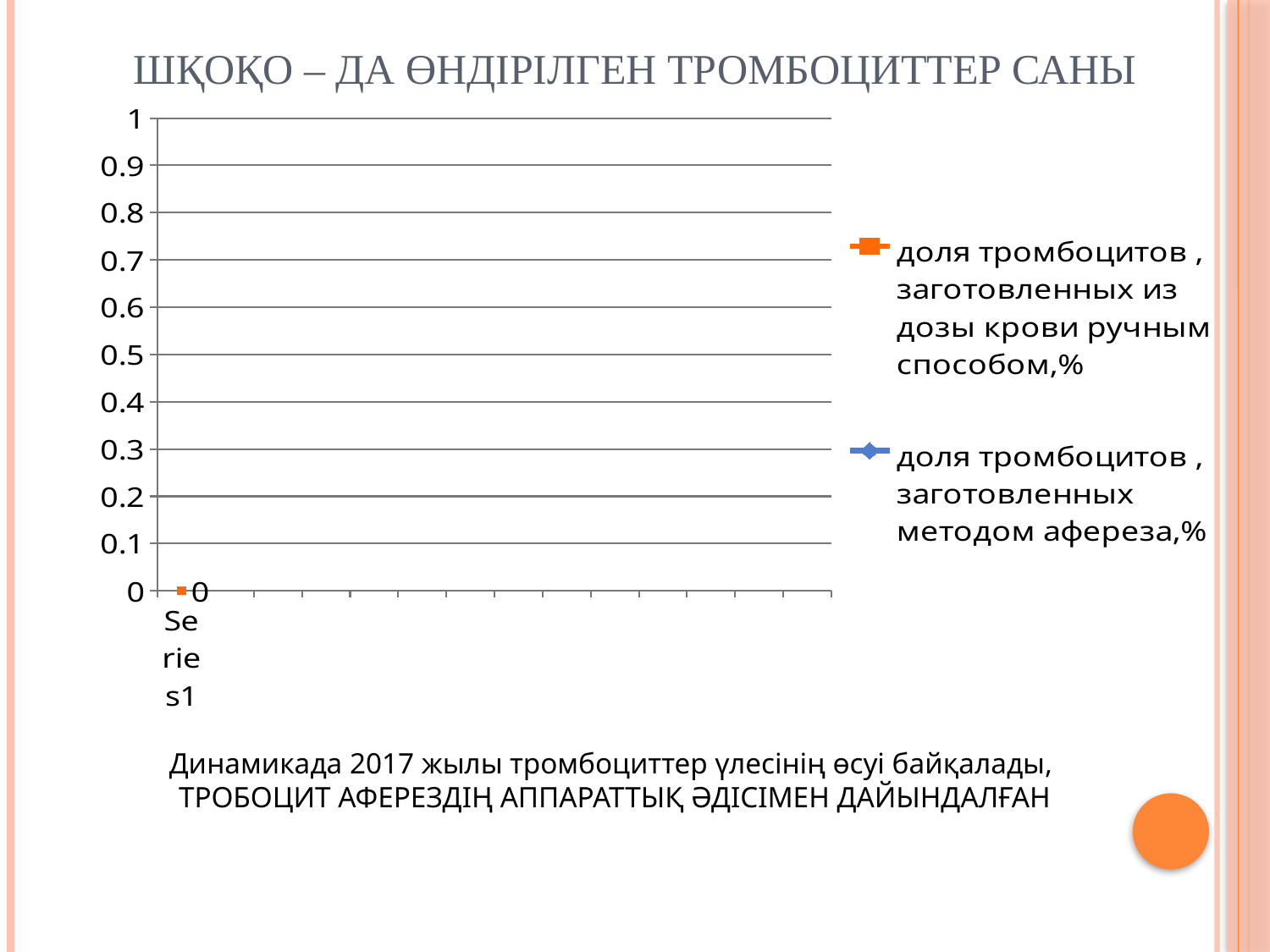
What is the category label shown on the x axis? Series1 What value is printed as a data label at Series1? 0 How many series does the legend list? 2 How many categories are shown on the x axis? 1 What kind of chart is shown on the slide? line chart What is the title of the chart? ШҚОҚО – ДА ӨНДІРІЛГЕН ТРОМБОЦИТТЕР САНЫ What is the highest value shown on the y axis? 1